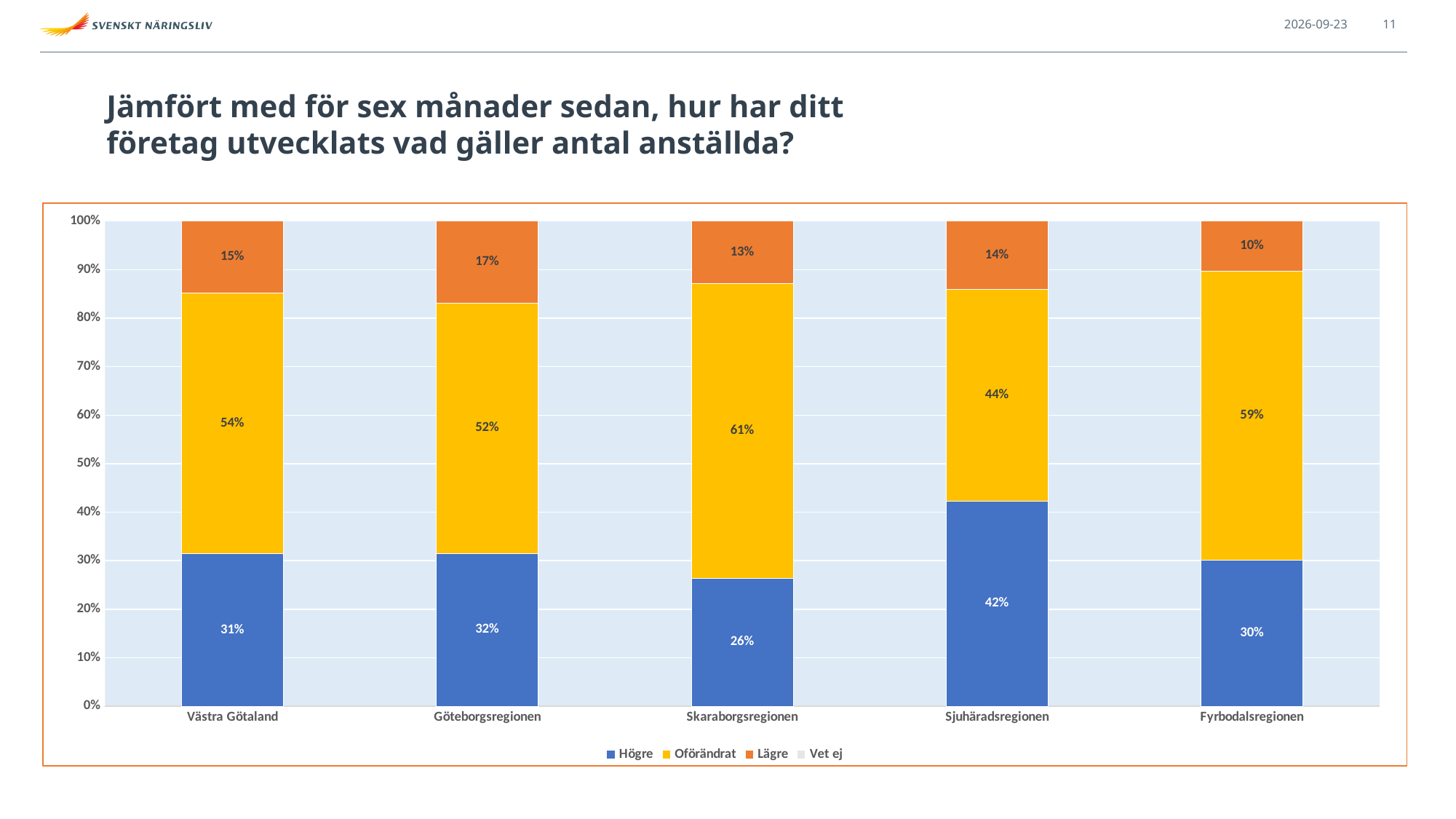
What is the value for Lägre in Fyrbodalsregionen? 10% Which colour represents Oförändrat in the chart? Yellow Which is larger, the Lägre value for Göteborgsregionen or for Skaraborgsregionen? Göteborgsregionen Which region has the lowest value for Lägre? Fyrbodalsregionen What is the value for Högre in Västra Götaland? 31% What kind of chart is shown on the slide? Stacked bar chart How many series does the legend list? 4 Which region has the highest value for Högre? Sjuhäradsregionen What is the value for Oförändrat in Skaraborgsregionen? 61% What is the value for Högre in Sjuhäradsregionen? 42% How many regions are shown on the x axis? 5 What is the difference between the Oförändrat values for Skaraborgsregionen and Sjuhäradsregionen? 17%